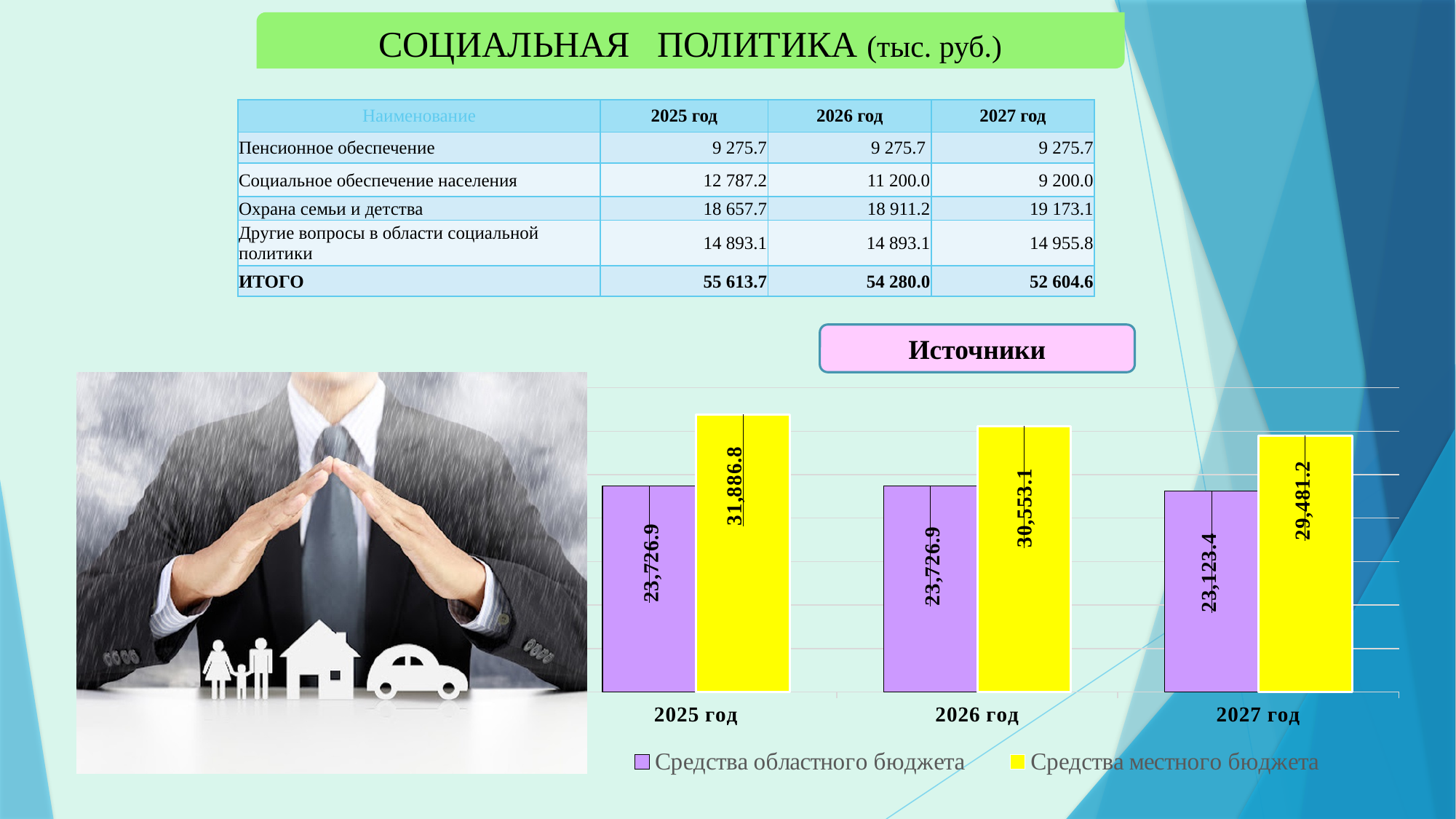
In the "Источники" chart, what is the value for Средства местного бюджета in 2026 год? 30,553.1 In the "Источники" chart, which year has the highest value for Средства местного бюджета? 2025 год In the "Источники" chart, what is the value for Средства областного бюджета in 2026 год? 23,726.9 In the "Источники" chart, do the values for Средства местного бюджета rise or fall from 2025 год to 2027 год? fall In the "Источники" chart, what is the difference between Средства местного бюджета and Средства областного бюджета in 2025 год? 8,159.9 In the "Источники" chart, which is larger in 2026 год: Средства областного бюджета or Средства местного бюджета? Средства местного бюджета In the "Источники" chart, what is the value for Средства областного бюджета in 2027 год? 23,123.4 In the "Источники" chart, what is the value for Средства местного бюджета in 2025 год? 31,886.8 How many series does the legend of the "Источники" chart list? 2 In the "Источники" chart, what is the difference between Средства местного бюджета and Средства областного бюджета in 2027 год? 6,357.8 What type of chart is shown under the heading "Источники"? bar chart In the "Источники" chart, which year has the lowest value for Средства областного бюджета? 2027 год